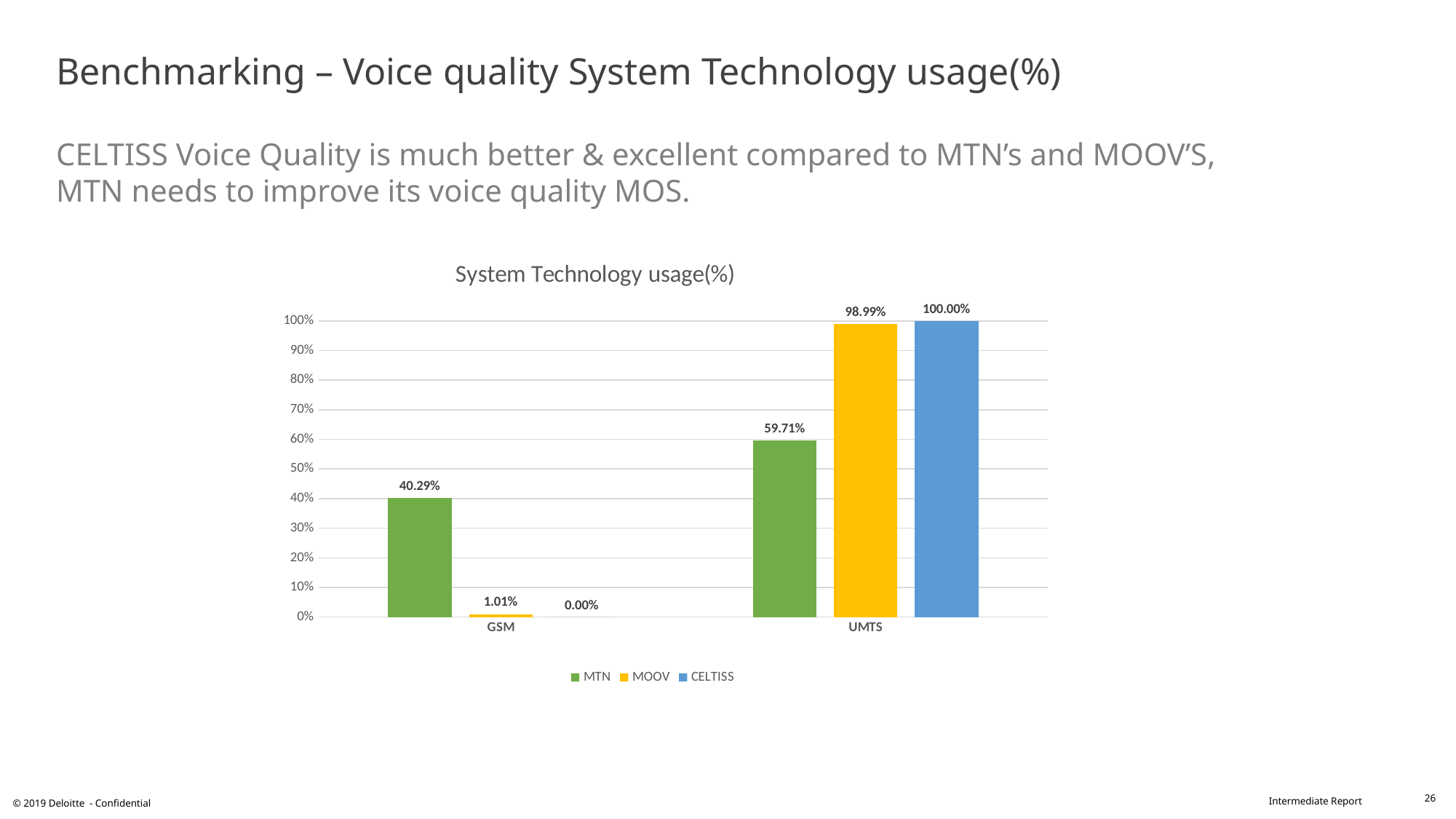
What is the value for CELTISS in the GSM category? 0.00% What kind of chart is shown on the slide? Bar chart How many series does the legend list? 3 How many categories are shown on the x axis? 2 Which series has the highest value in the UMTS category? CELTISS What is the title of the chart? System Technology usage(%) What is the value for MTN in the GSM category? 40.29% Which series has the lowest value in the GSM category? CELTISS What is the difference between MTN's UMTS value and MTN's GSM value? 19.42% Which is larger: MOOV's GSM value or MTN's GSM value? MTN's GSM value What is the value for MOOV in the UMTS category? 98.99% What is the value for MTN in the UMTS category? 59.71%